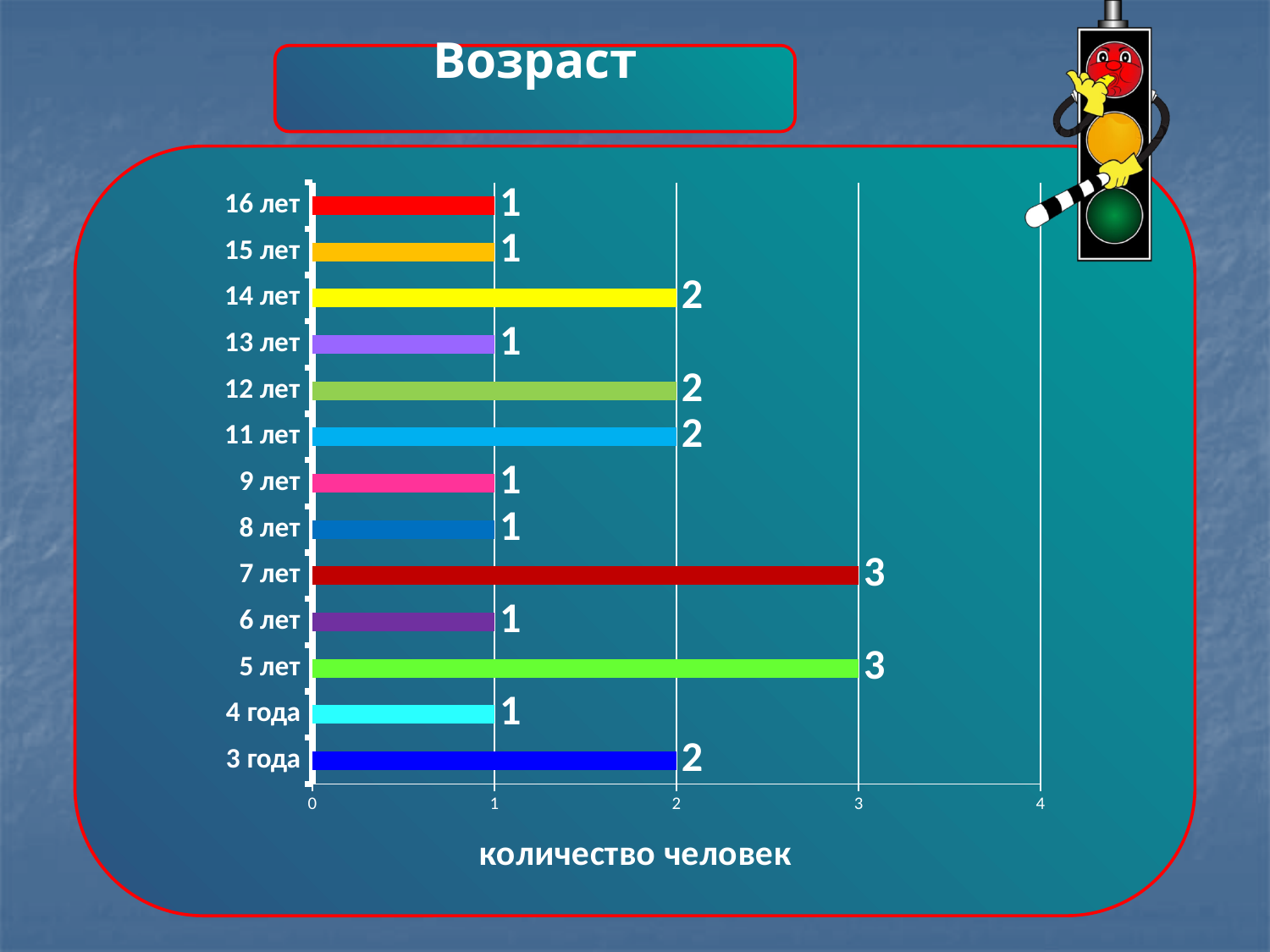
What is the difference between the values for 7 лет and 8 лет? 2 What is the value for 13 лет? 1 What kind of chart is shown on the slide? bar chart What is the value for 5 лет? 3 What is the difference between the values for 12 лет and 15 лет? 1 What is the value for 14 лет? 2 Which is larger, the value for 11 лет or the value for 9 лет? 11 лет How many age categories are plotted on the chart? 13 What is the value for 7 лет? 3 What is the title of the chart? Возраст What is the value for 3 года? 2 Which is larger, the value for 5 лет or the value for 6 лет? 5 лет